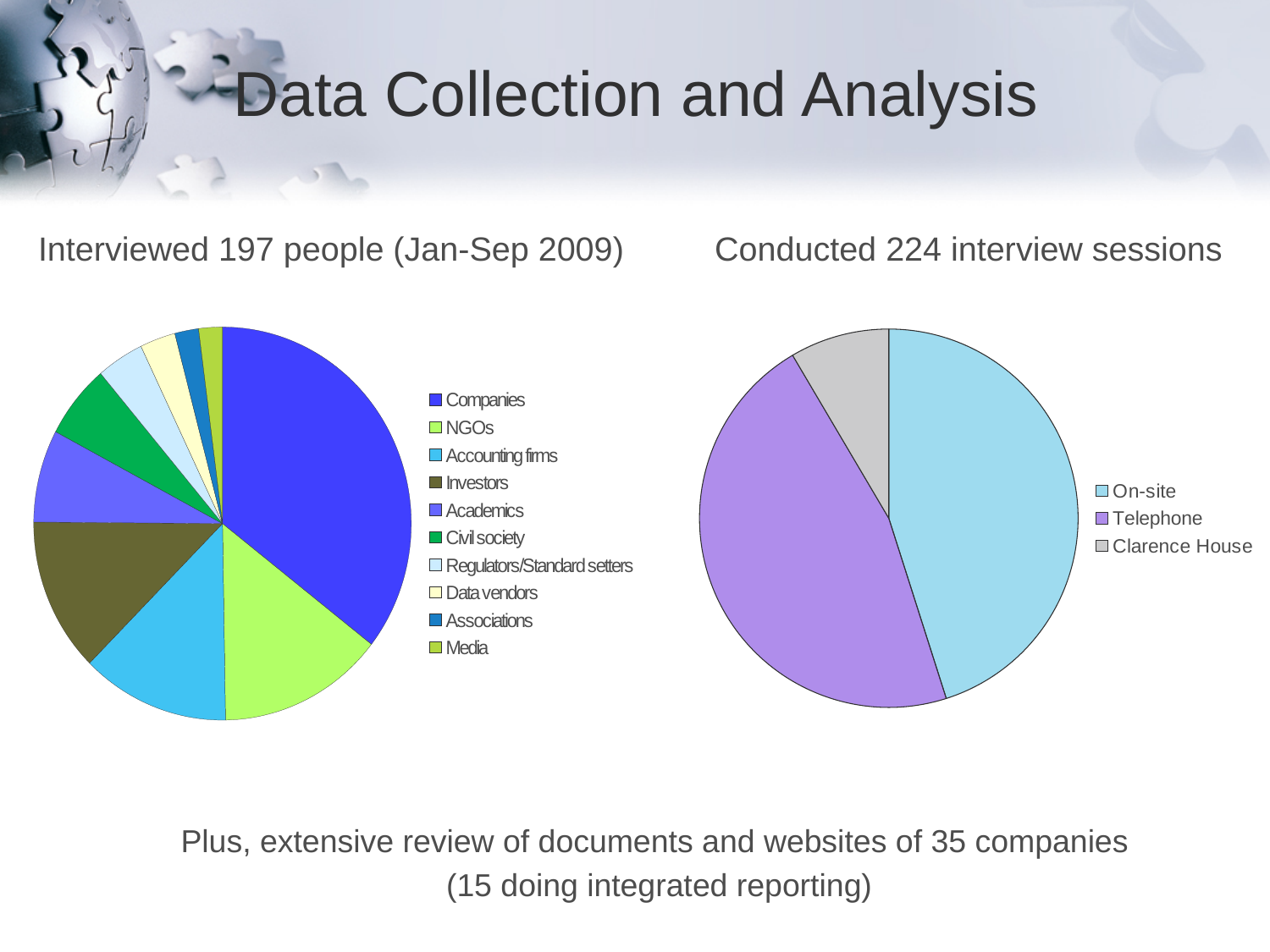
In the left chart (Interviewed 197 people), which slice is larger, Investors or Academics? Investors In the left chart (Interviewed 197 people), how many categories does the legend list? 10 In the right chart (Conducted 224 interview sessions), what colour is the Telephone slice? Purple In the right chart (Conducted 224 interview sessions), which category has the smallest slice? Clarence House What kind of chart is the left chart titled "Interviewed 197 people (Jan-Sep 2009)"? Pie chart In the left chart (Interviewed 197 people), which legend entry is listed last? Media In the left chart (Interviewed 197 people), which category has the largest slice? Companies In the right chart (Conducted 224 interview sessions), how many categories does the legend list? 3 What kind of chart is the right chart titled "Conducted 224 interview sessions"? Pie chart In the right chart (Conducted 224 interview sessions), which slice is larger, Telephone or Clarence House? Telephone In the left chart (Interviewed 197 people), which slice is larger, Companies or NGOs? Companies